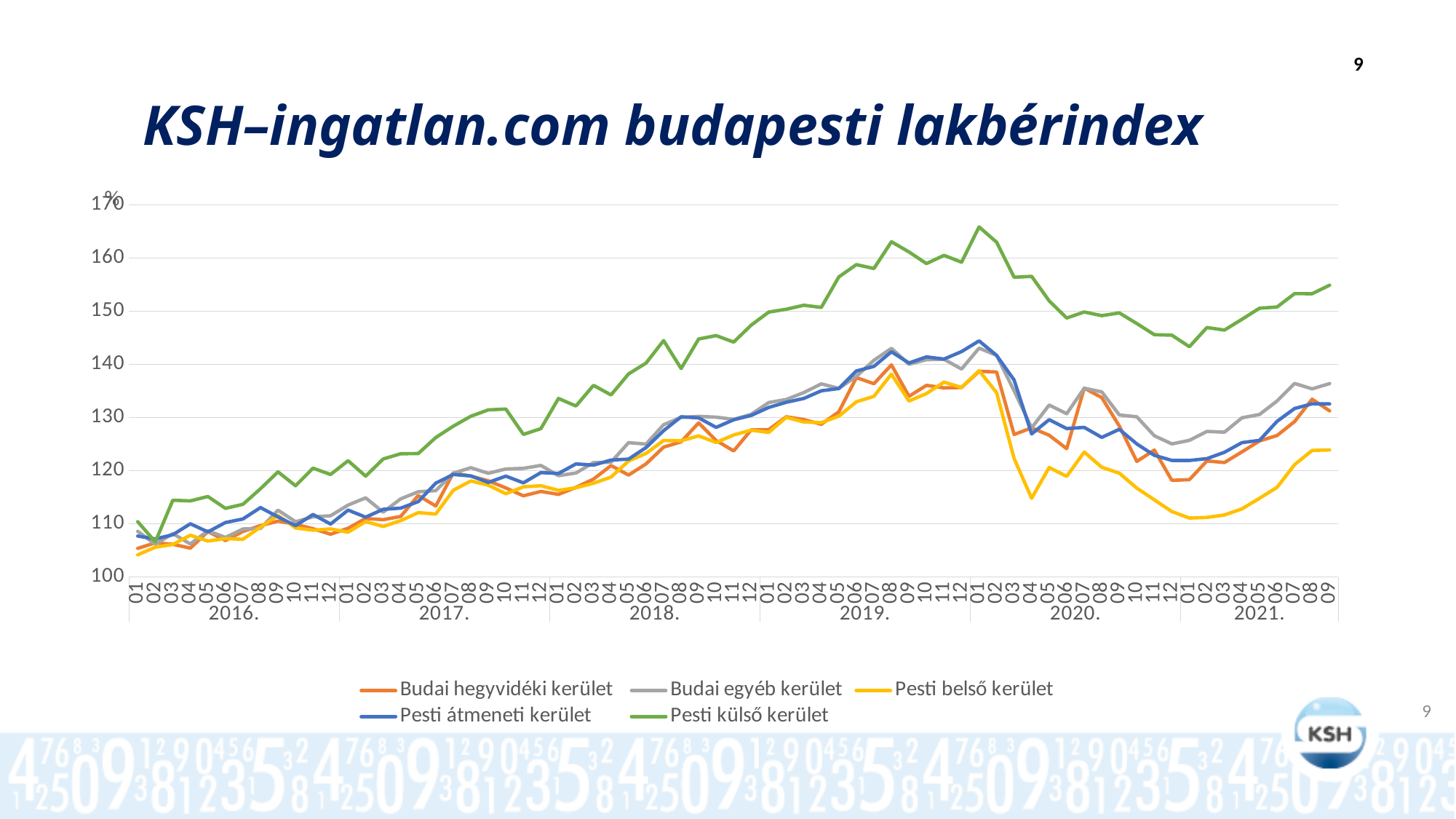
In 2020. 04, which is larger: Pesti külső kerület or Pesti belső kerület? Pesti külső kerület Which series has the lowest value at the end of the chart (2021. 09)? Pesti belső kerület What is the title of the chart? KSH–ingatlan.com budapesti lakbérindex Is the value for Pesti külső kerület in 2021. 09 greater or less than 150? greater Is the value for Pesti belső kerület in 2021. 01 greater or less than 120? less How many series does the legend list? 5 What kind of chart is shown on the slide? line chart Which series is drawn with the green line? Pesti külső kerület Which series has the highest value at the end of the chart (2021. 09)? Pesti külső kerület Does the Pesti külső kerület line generally rise or fall from the start of 2016 to the end of 2019? rise Is the peak value for Pesti külső kerület in 2020. 01 greater or less than 160? greater Which series reaches the highest peak anywhere on the chart? Pesti külső kerület